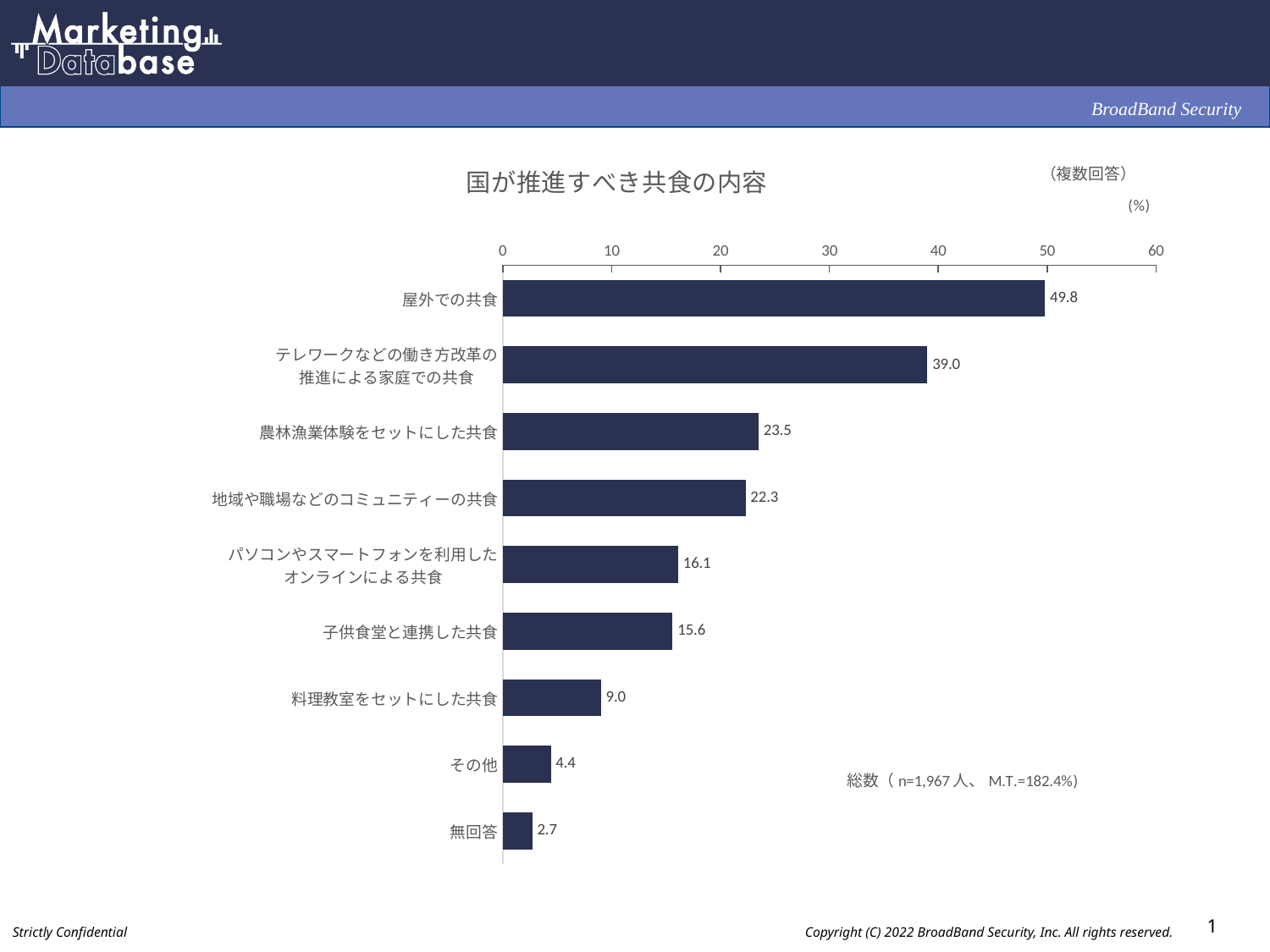
What is the value for 無回答? 2.7 What kind of chart is shown on the slide? Bar chart Which is larger, the value for 子供食堂と連携した共食 or the value for 料理教室をセットにした共食? 子供食堂と連携した共食 What is the title of the chart? 国が推進すべき共食の内容 How many categories are shown in the chart? 9 Which category has the lowest value? 無回答 What is the value for 屋外での共食? 49.8 What is the difference between the values for 屋外での共食 and テレワークなどの働き方改革の推進による家庭での共食? 10.8 What is the value for 農林漁業体験をセットにした共食? 23.5 What is the value for 料理教室をセットにした共食? 9.0 Which category has the highest value? 屋外での共食 Is the value for 地域や職場などのコミュニティーの共食 greater or less than 20? greater